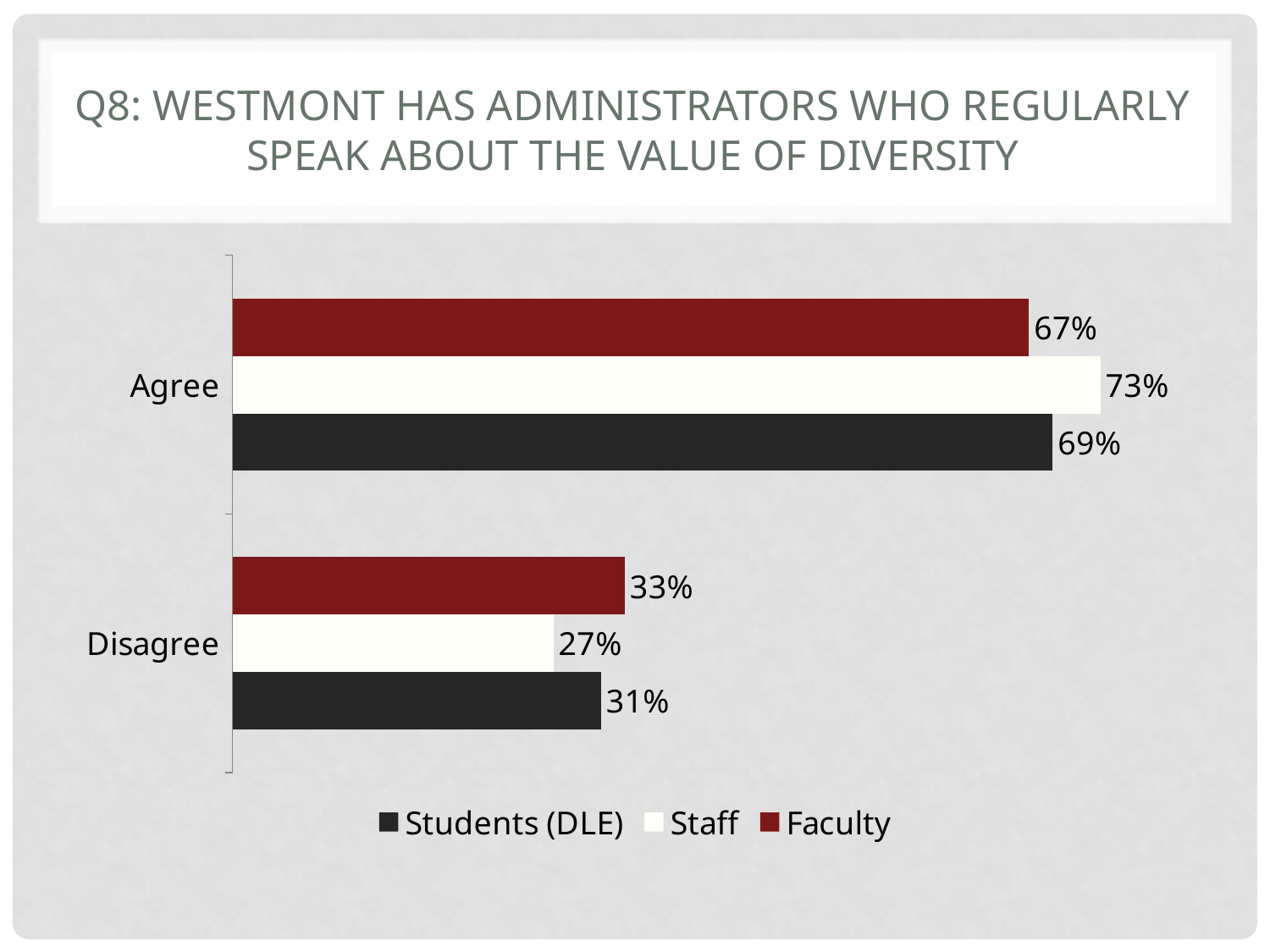
What percentage of Staff disagree with the statement? 27% How many series does the legend list? 3 How many categories are shown on the vertical axis? 2 What percentage of Staff agree with the statement? 73% Which series is shown in dark red? Faculty Which is larger: the Faculty Disagree value or the Students (DLE) Disagree value? Faculty Disagree What percentage of Students (DLE) disagree with the statement? 31% Which group has the lowest Disagree percentage? Staff Which group has the highest Agree percentage? Staff What kind of chart is shown on the slide? Bar chart What percentage of Faculty agree with the statement? 67% What is the difference between the Staff and Faculty Agree percentages? 6%